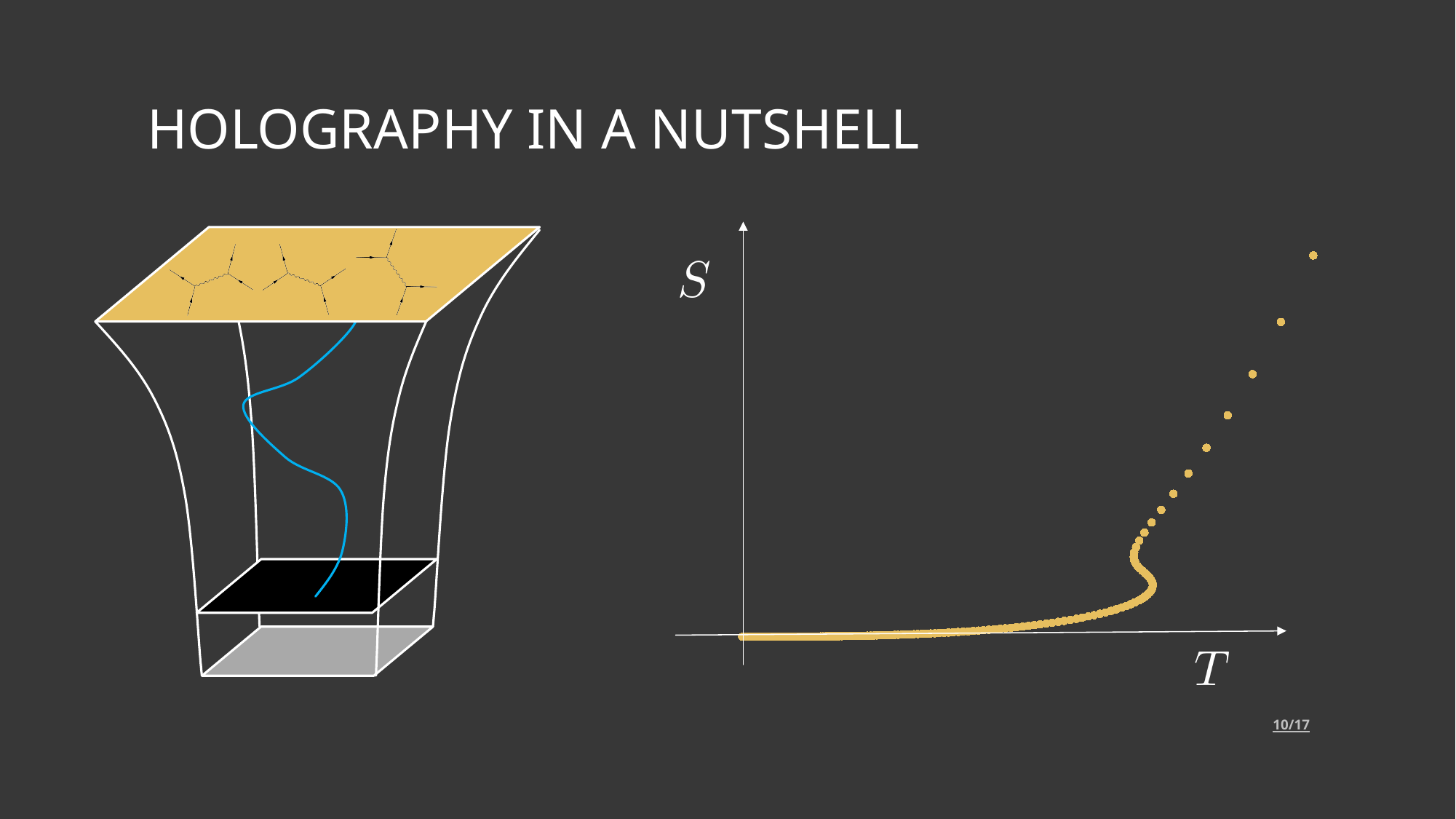
Overall, does S rise or fall as T increases along the x axis? rise What is the label on the vertical axis of the chart? S What is the label on the horizontal axis of the chart? T How many data series are plotted in the chart? 1 What kind of chart is shown on the right side of the slide? scatter plot